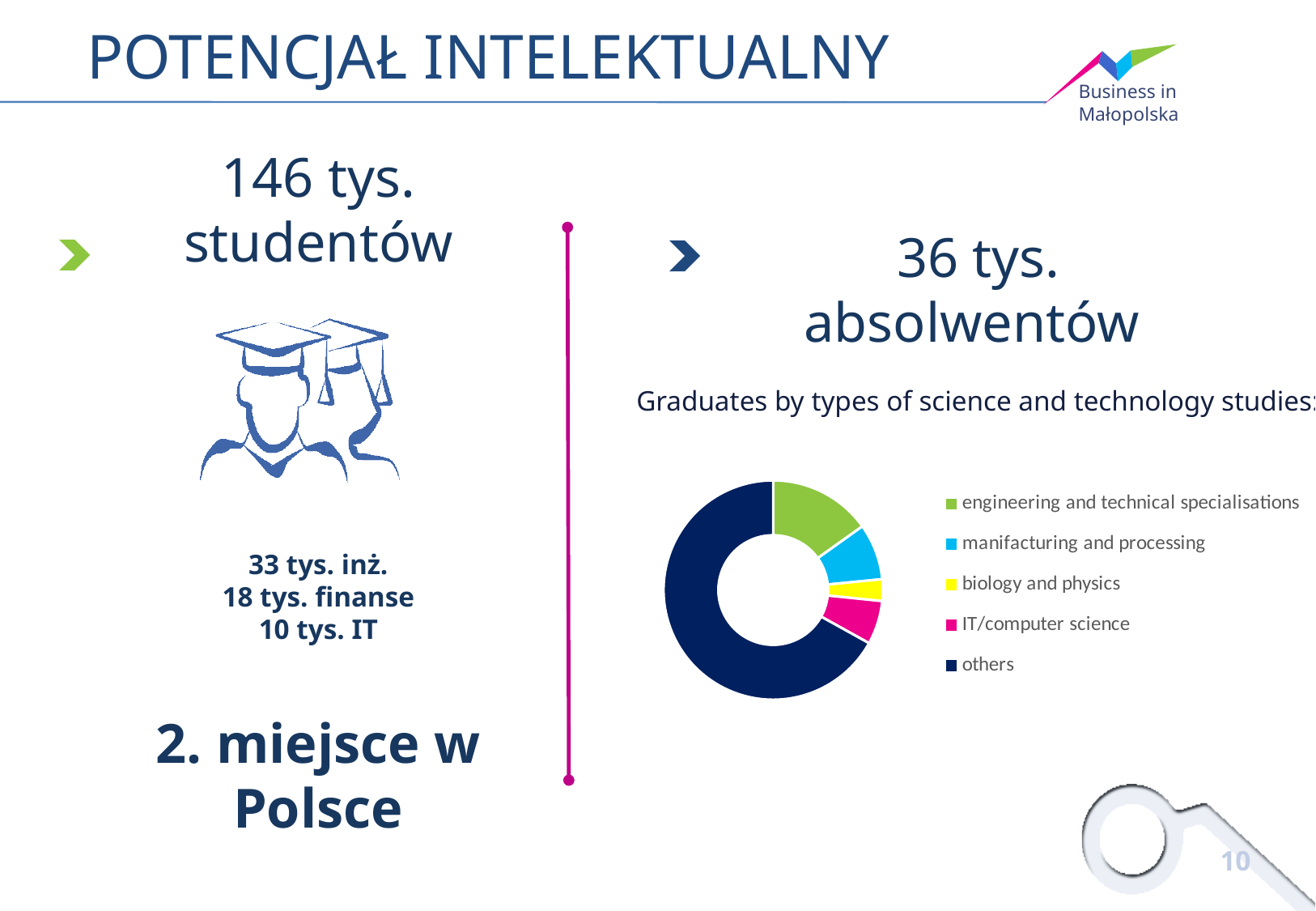
What is the title of the pie chart on the slide? Graduates by types of science and technology studies What colour represents IT/computer science in the pie chart of graduates? Pink (magenta) How many categories does the pie chart of graduates by types of science and technology studies show? 5 In the pie chart of graduates, which slice is larger: engineering and technical specialisations or IT/computer science? engineering and technical specialisations In the pie chart of graduates, which slice is larger: IT/computer science or biology and physics? IT/computer science In the pie chart of graduates, which slice is larger: others or engineering and technical specialisations? others Which category has the smallest slice in the pie chart of graduates by types of science and technology studies? biology and physics What kind of chart is shown under "Graduates by types of science and technology studies"? Pie chart (donut) Which category has the largest slice in the pie chart of graduates by types of science and technology studies? others